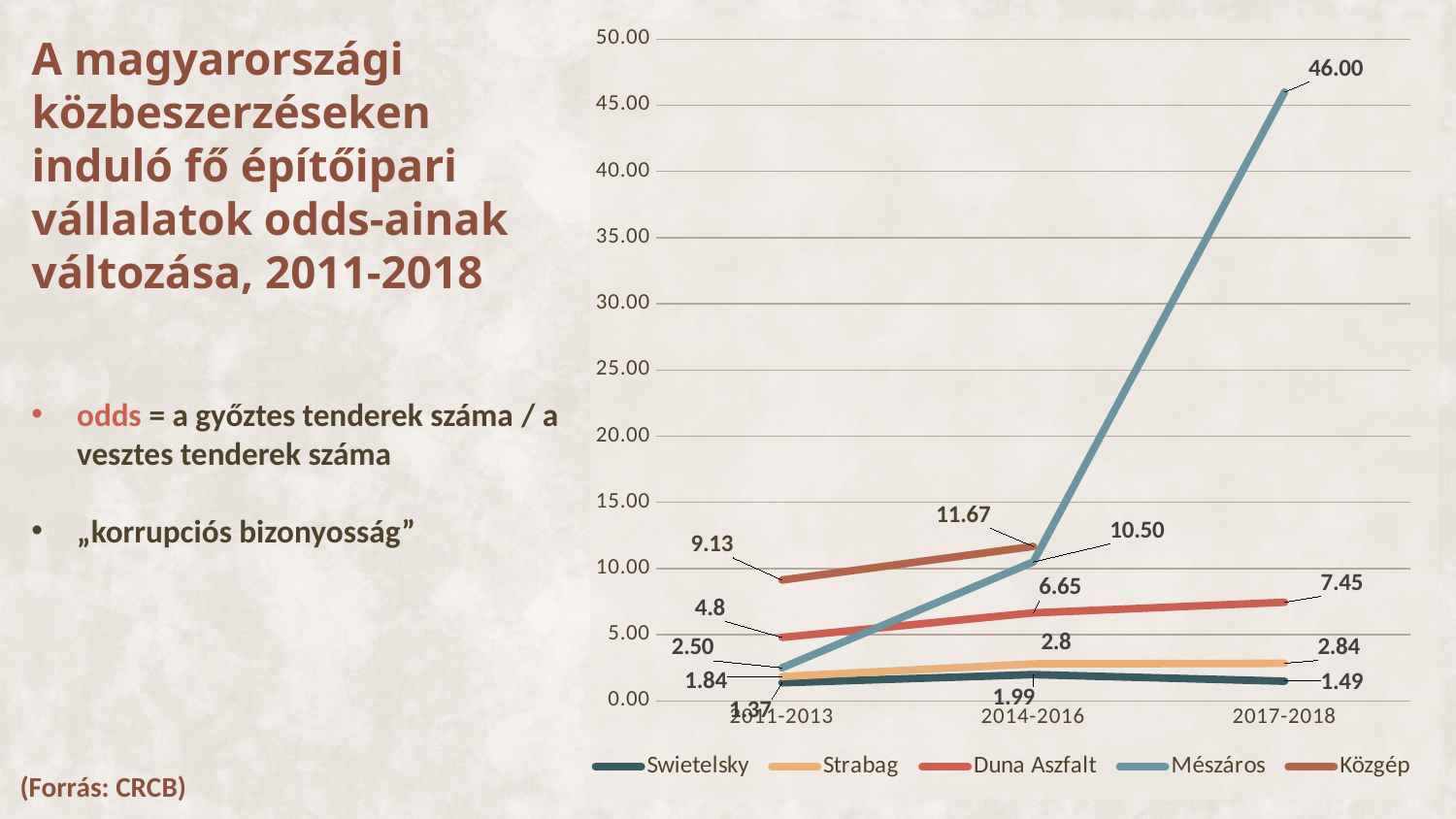
In 2014-2016, which is larger: the value for Közgép or the value for Mészáros? Közgép How many series does the legend list? 5 Which company has the highest value in 2017-2018? Mészáros What is the value for Mészáros in 2017-2018? 46.00 Which company has the lowest value in 2011-2013? Swietelsky By how much did the value for Mészáros increase from 2014-2016 to 2017-2018? 35.50 What is the value for Duna Aszfalt in 2017-2018? 7.45 What is the value for Strabag in 2014-2016? 2.8 How many periods are shown on the x axis? 3 What kind of chart is shown on the slide? line chart Does the value for Mészáros rise or fall from 2011-2013 to 2017-2018? rise What is the value for Közgép in 2011-2013? 9.13